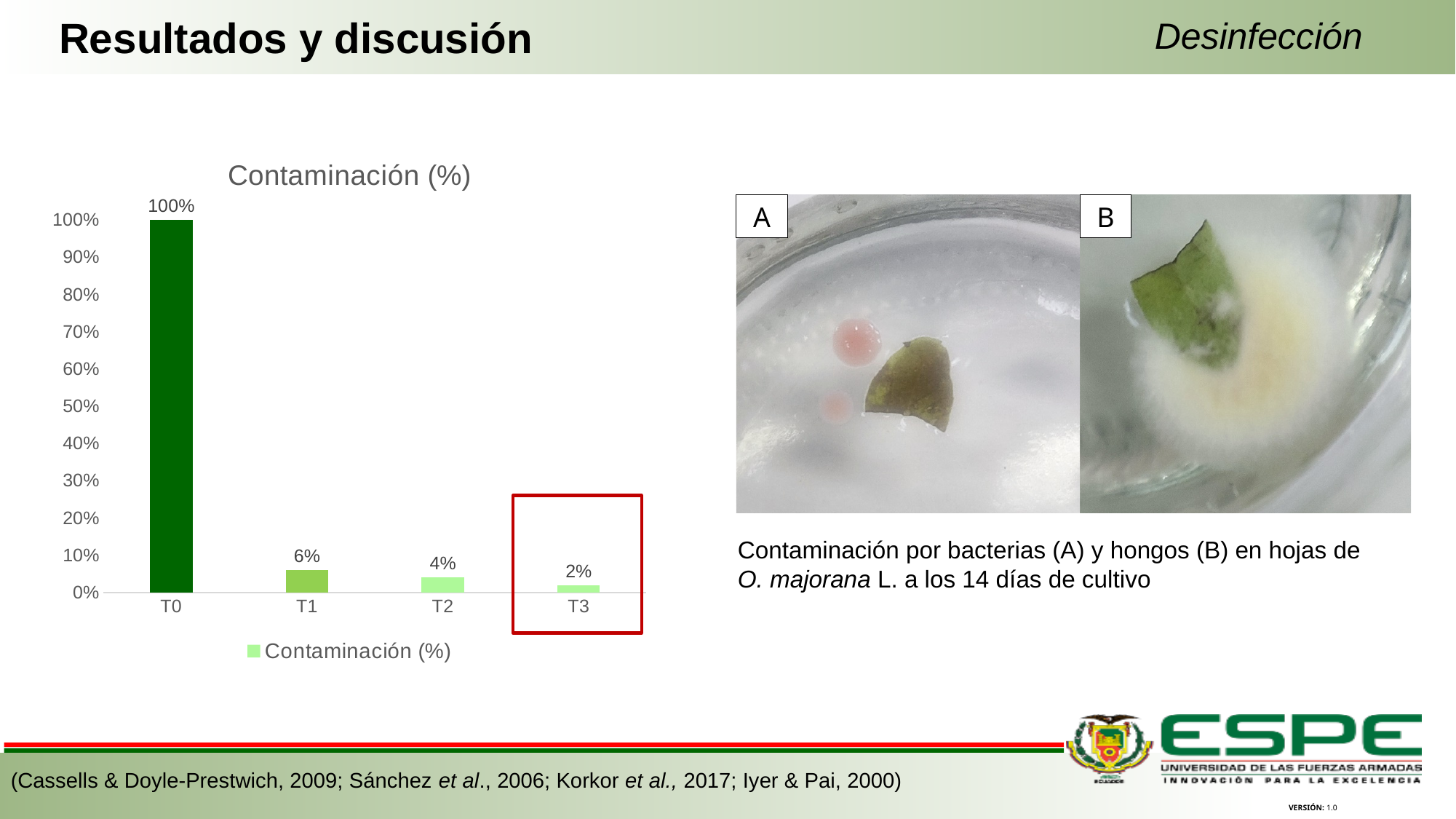
What is the difference in contamination between T1 and T3? 4% Which treatment has the lowest contamination? T3 What is the contamination value for T0? 100% What is the contamination value for T2? 4% What is the contamination value for T1? 6% Which has a higher contamination value, T1 or T2? T1 How many treatments are shown on the x axis of the chart? 4 What is the title of the chart? Contaminación (%) What is the contamination value for T3? 2% Which treatment has the highest contamination? T0 Do the contamination values rise or fall from T0 to T3? Fall What kind of chart is shown on the slide? Bar chart